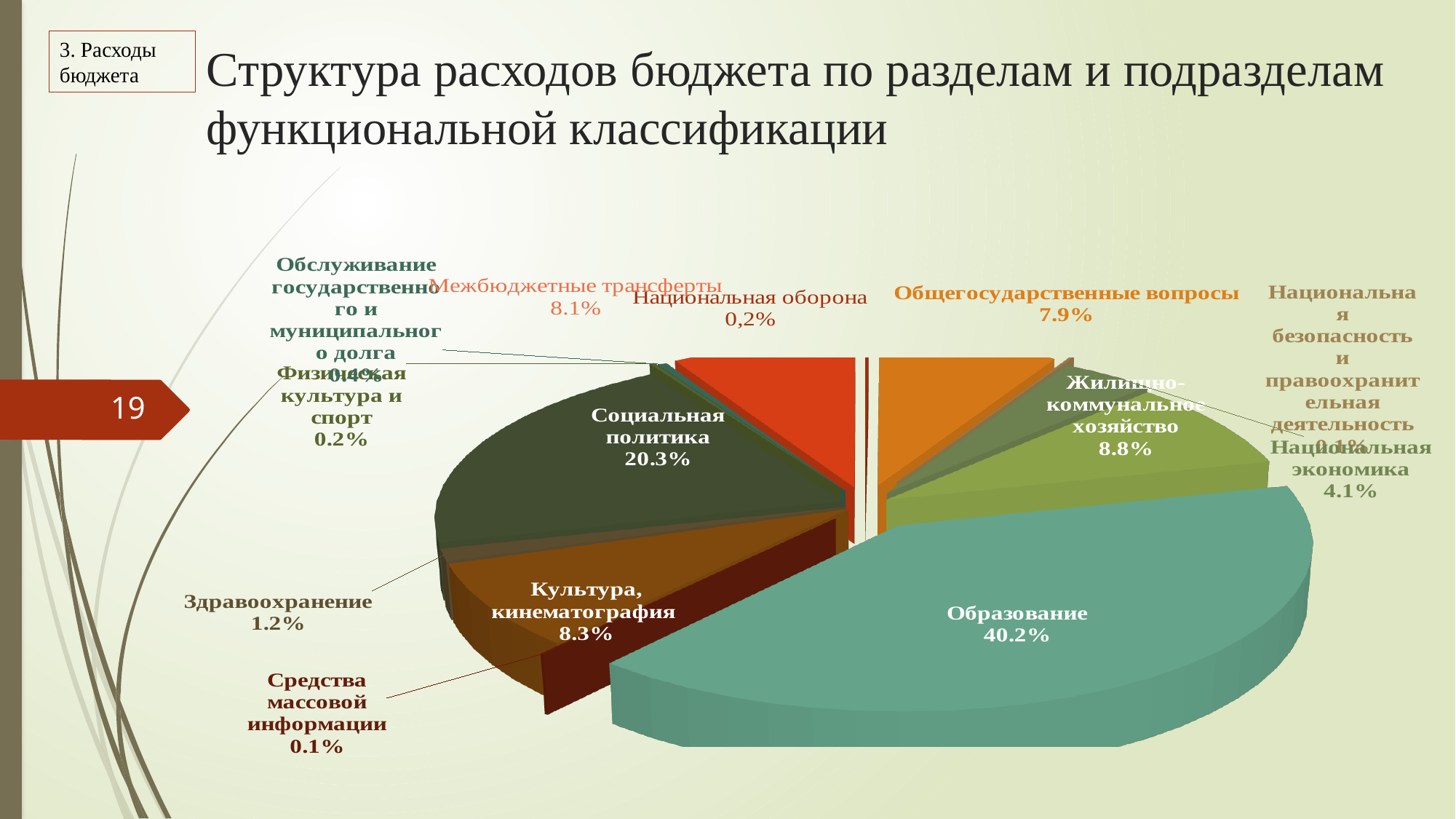
What kind of chart is shown on the slide? pie chart What is the value shown for Социальная политика? 20.3% What share is shown for Национальная экономика? 4.1% What percentage is labelled for Межбюджетные трансферты? 8.1% What is the value for Культура, кинематография? 8.3% What is the value shown for Здравоохранение? 1.2% Which category has the largest share of the pie? Образование What is the difference between the shares of Образование and Социальная политика? 19.9% What share of budget expenditure goes to Образование? 40.2% Which is larger, Жилищно-коммунальное хозяйство or Культура, кинематография? Жилищно-коммунальное хозяйство What percentage is shown for Жилищно-коммунальное хозяйство? 8.8% What is the title of the slide containing the chart? Структура расходов бюджета по разделам и подразделам функциональной классификации